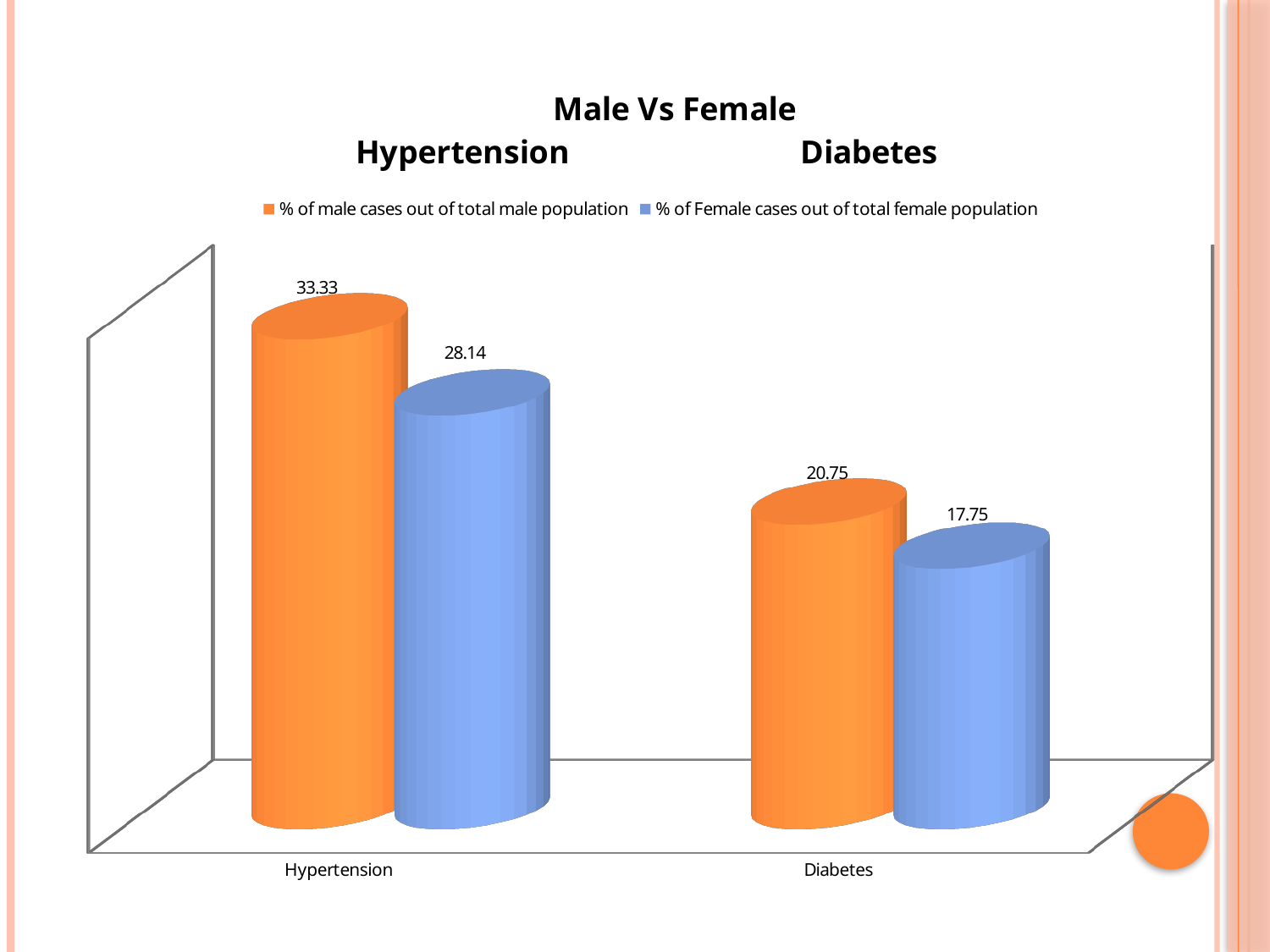
What kind of chart is shown on the slide? bar chart What is the % of Female cases out of total female population for Diabetes? 17.75 What is the % of male cases out of total male population for Diabetes? 20.75 Which category has the highest value for % of male cases out of total male population? Hypertension Which category has the lowest value for % of Female cases out of total female population? Diabetes How many series does the legend list? 2 What is the % of male cases out of total male population for Hypertension? 33.33 What is the difference between the male and female values for Hypertension? 5.19 What is the difference between the male and female values for Diabetes? 3 How many categories are shown on the x axis? 2 For Diabetes, which is larger: the male value or the female value? the male value What is the % of Female cases out of total female population for Hypertension? 28.14